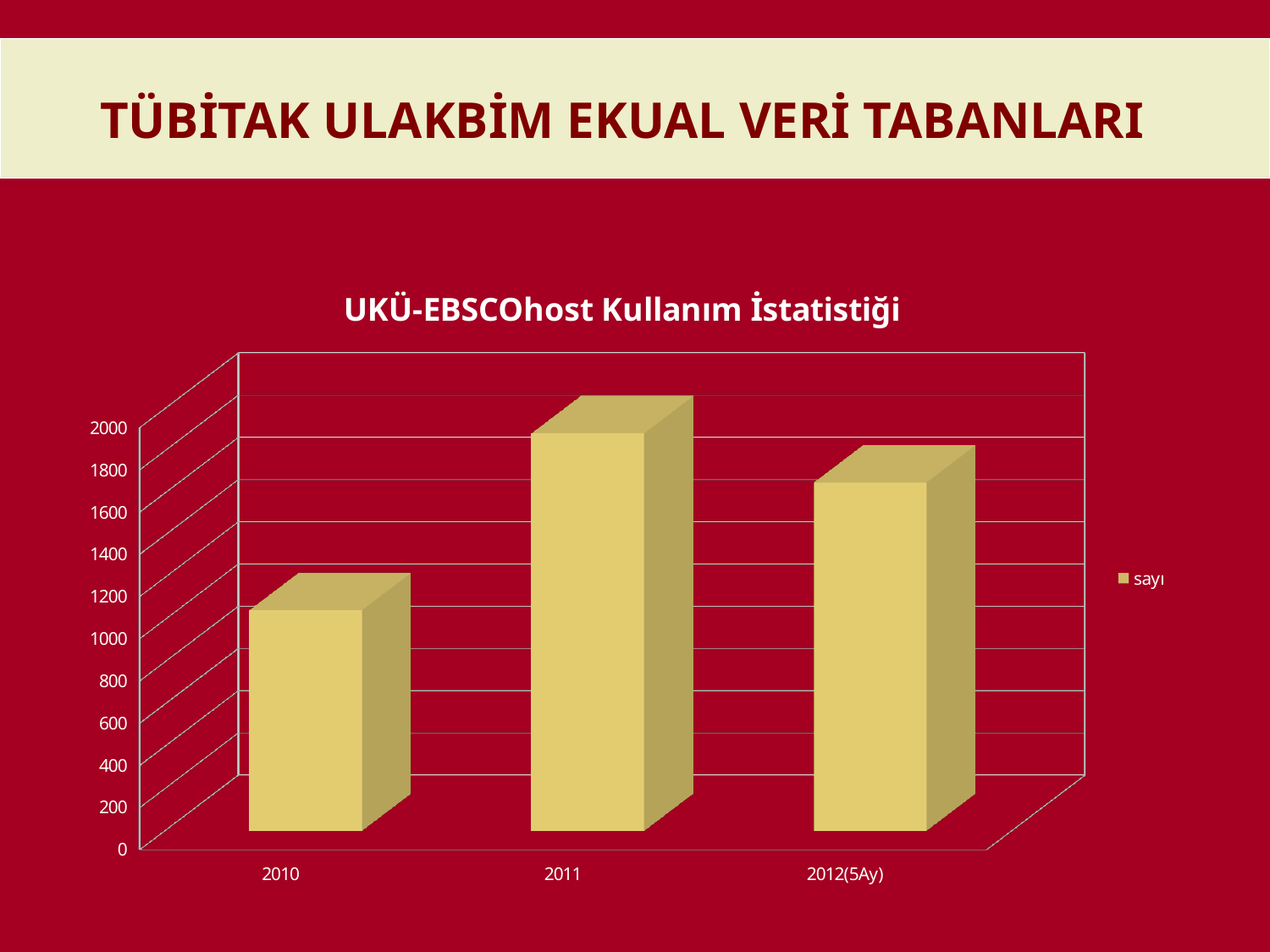
What kind of chart is shown on the slide? bar chart How many series does the legend list? 1 Which is larger, the value for 2011 or the value for 2012(5Ay)? 2011 Which category has the lowest value? 2010 Is the value for 2010 greater or less than 800? greater Which year has the highest value? 2011 Does the value rise or fall from 2010 to 2011? rise What is the name of the series shown in the legend? sayı What is the title of the chart? UKÜ-EBSCOhost Kullanım İstatistiği How many categories are shown on the x axis of the chart? 3 Is the value for 2011 greater or less than 1600? greater Is the value for 2010 greater or less than 1400? less